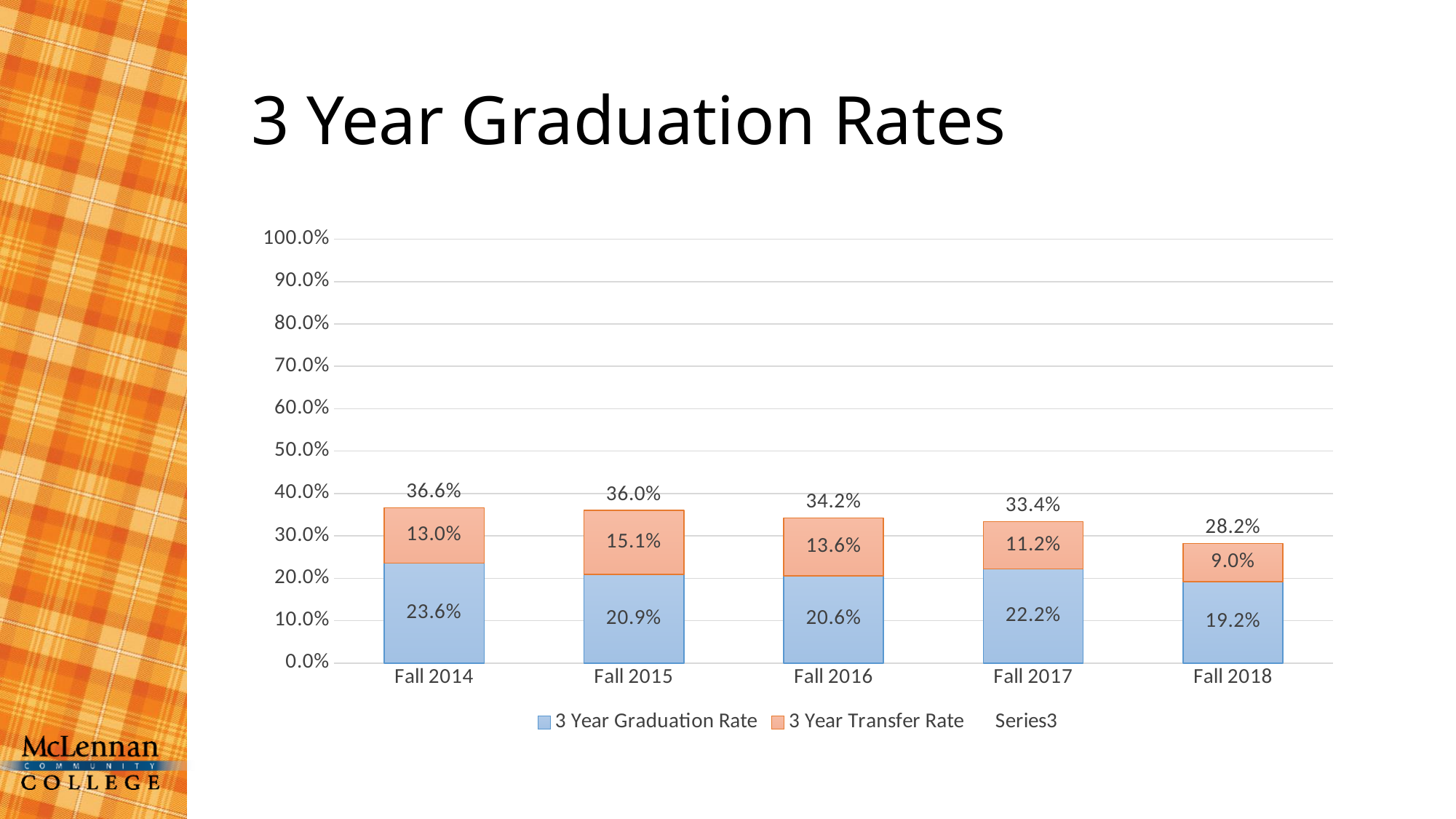
Which is larger, the 3 Year Transfer Rate for Fall 2016 or for Fall 2017? Fall 2016 What is the total of the stacked bar for Fall 2016? 34.2% Is the total for Fall 2018 greater or less than 30.0%? less What kind of chart is shown on the slide? Stacked bar chart How many series does the legend list? 3 How many cohorts are shown on the x axis? 5 Which cohort has the lowest 3 Year Transfer Rate? Fall 2018 What is the difference between the 3 Year Graduation Rate for Fall 2017 and Fall 2018? 3.0% What is the 3 Year Transfer Rate for Fall 2015? 15.1% Which cohort has the highest 3 Year Graduation Rate? Fall 2014 What is the 3 Year Graduation Rate for Fall 2014? 23.6% Do the stacked bar totals rise or fall from Fall 2014 to Fall 2018? Fall